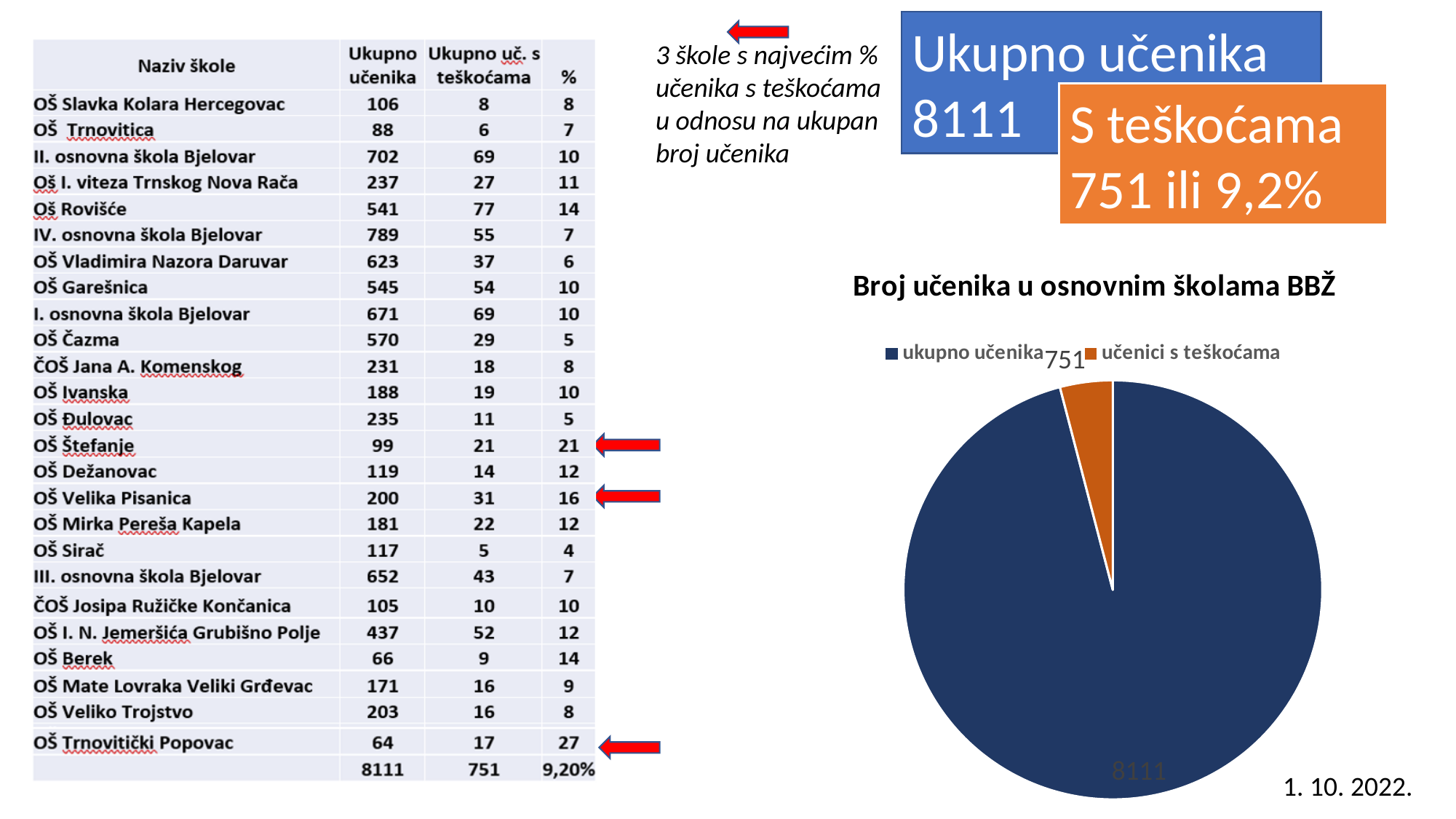
What is the difference between the 'ukupno učenika' value and the 'učenici s teškoćama' value in the pie chart? 7360 What colour is the 'učenici s teškoćama' slice in the pie chart? orange What value is shown for the 'ukupno učenika' slice in the pie chart? 8111 Which slice of the pie chart is the smallest? učenici s teškoćama Which slice of the pie chart is the largest? ukupno učenika What value is shown for the 'učenici s teškoćama' slice in the pie chart? 751 What kind of chart is shown on the slide? pie chart What is the title of the pie chart? Broj učenika u osnovnim školama BBŽ How many entries does the legend of the pie chart list? 2 In the pie chart, which is larger: 'ukupno učenika' or 'učenici s teškoćama'? ukupno učenika How many slices does the pie chart have? 2